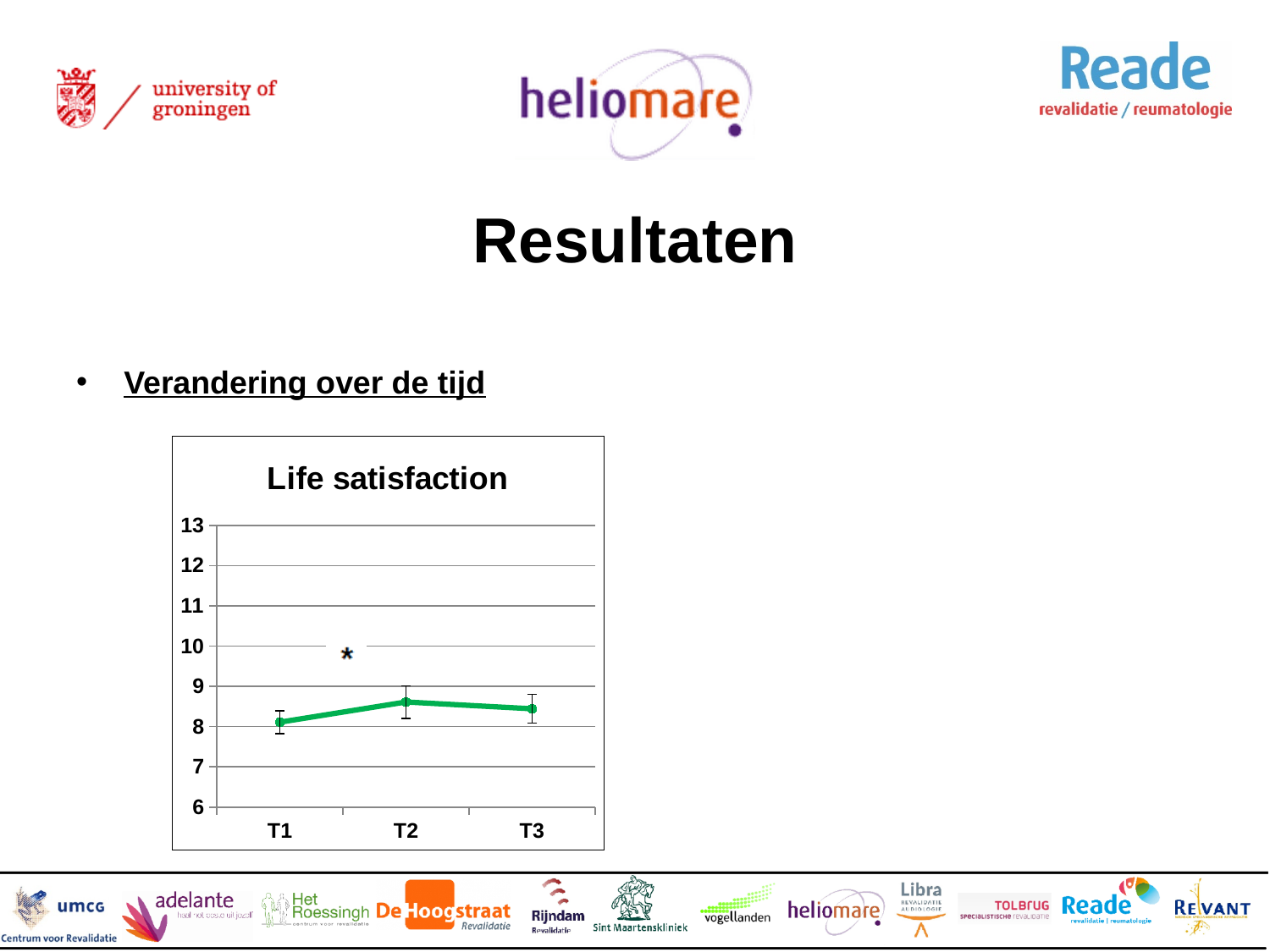
What type of chart is shown under "Life satisfaction"? line chart What is the title of the chart? Life satisfaction Which is larger, the life satisfaction value at T1 or at T2? T2 Does life satisfaction rise or fall from T1 to T2? rise Is the life satisfaction value at T1 greater or less than 9? less Is the life satisfaction value at T3 greater or less than 9? less Is the life satisfaction value at T2 greater or less than 8? greater What is the highest value shown on the y axis of the Life satisfaction chart? 13 Which time point has the lowest life satisfaction value? T1 What is the lowest value shown on the y axis of the Life satisfaction chart? 6 How many time points are plotted on the x axis of the Life satisfaction chart? 3